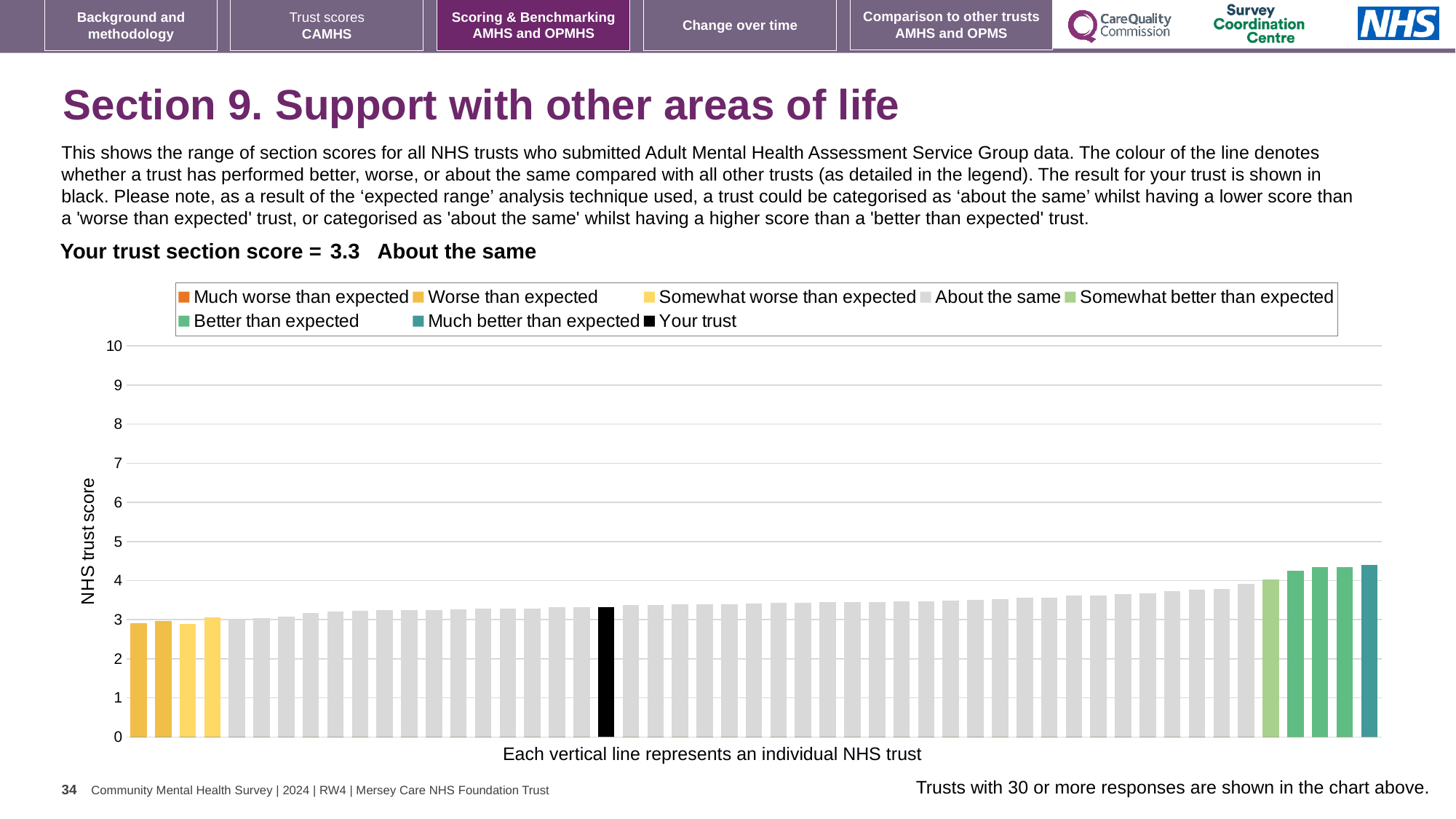
Is the value of the black 'Your trust' bar greater or less than 4? less How many bars are coloured as 'Better than expected' (mid green)? 3 What kind of chart is shown on the slide? bar chart What is the section score for your trust shown on the slide? 3.3 Is the value of the tallest bar in the chart greater or less than 4? greater Do the bar values rise or fall moving from left to right along the x axis? rise How many entries does the chart legend list? 8 Is the value of the tallest bar in the chart greater or less than 5? less What is the label on the vertical axis of the chart? NHS trust score Which legend category does the tallest bar belong to? Much better than expected What colour is the bar representing your trust? black